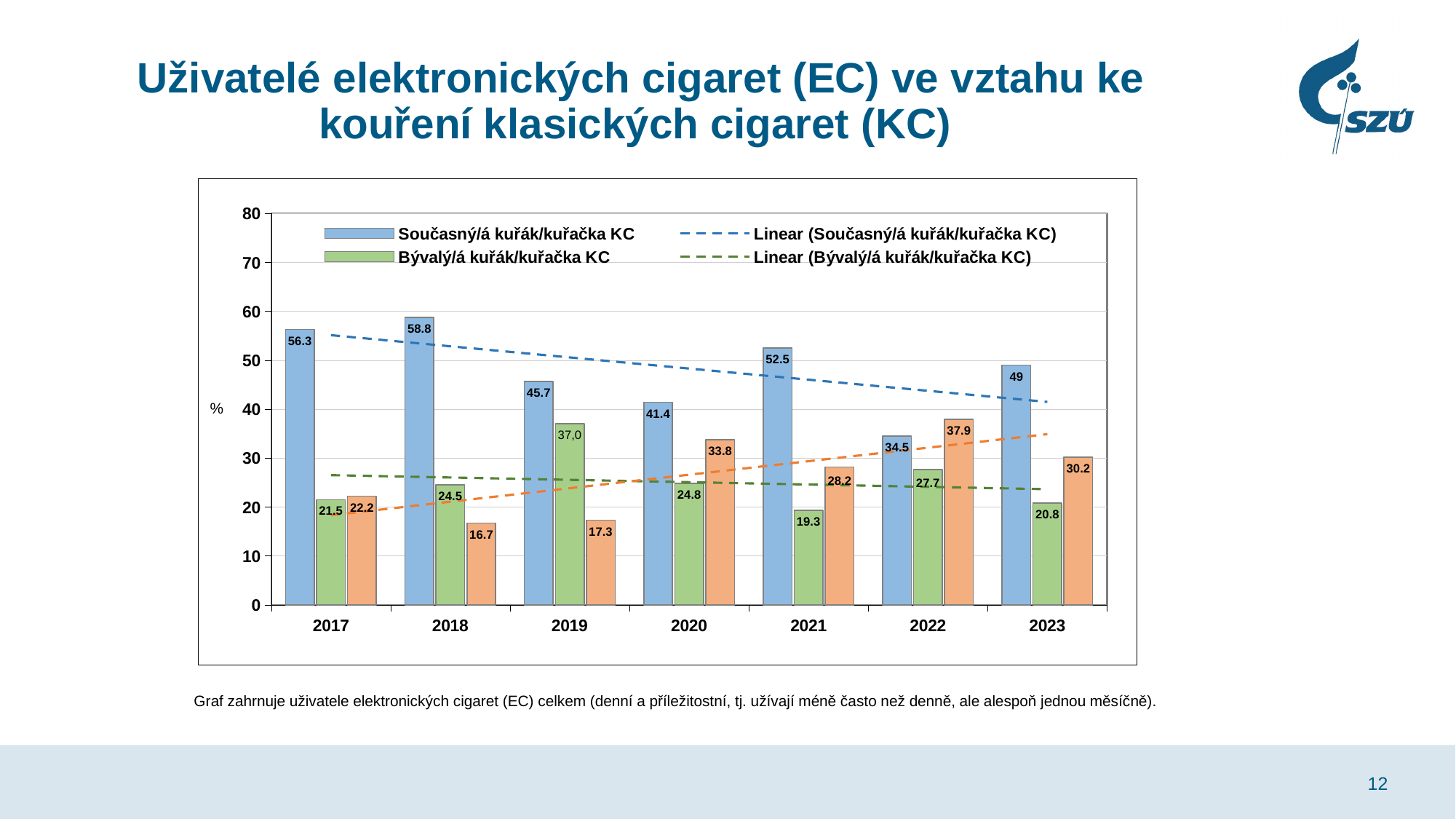
What is the value for Bývalý/á kuřák/kuřačka KC in 2019? 37,0 In which year is the value for Současný/á kuřák/kuřačka KC lowest? 2022 What is the value for Současný/á kuřák/kuřačka KC in 2018? 58.8 What is the difference between the Bývalý/á kuřák/kuřačka KC values in 2022 and 2021? 8.4 In which year is the value for Bývalý/á kuřák/kuřačka KC highest? 2019 What is the value for Současný/á kuřák/kuřačka KC in 2023? 49 Which year has the larger value for Současný/á kuřák/kuřačka KC, 2021 or 2023? 2021 In which year is the value for Současný/á kuřák/kuřačka KC highest? 2018 What is the difference between the Současný/á kuřák/kuřačka KC values in 2018 and 2017? 2.5 How many entries does the legend list? 4 How many years are shown on the x axis? 7 In which year is the value for Bývalý/á kuřák/kuřačka KC lowest? 2021